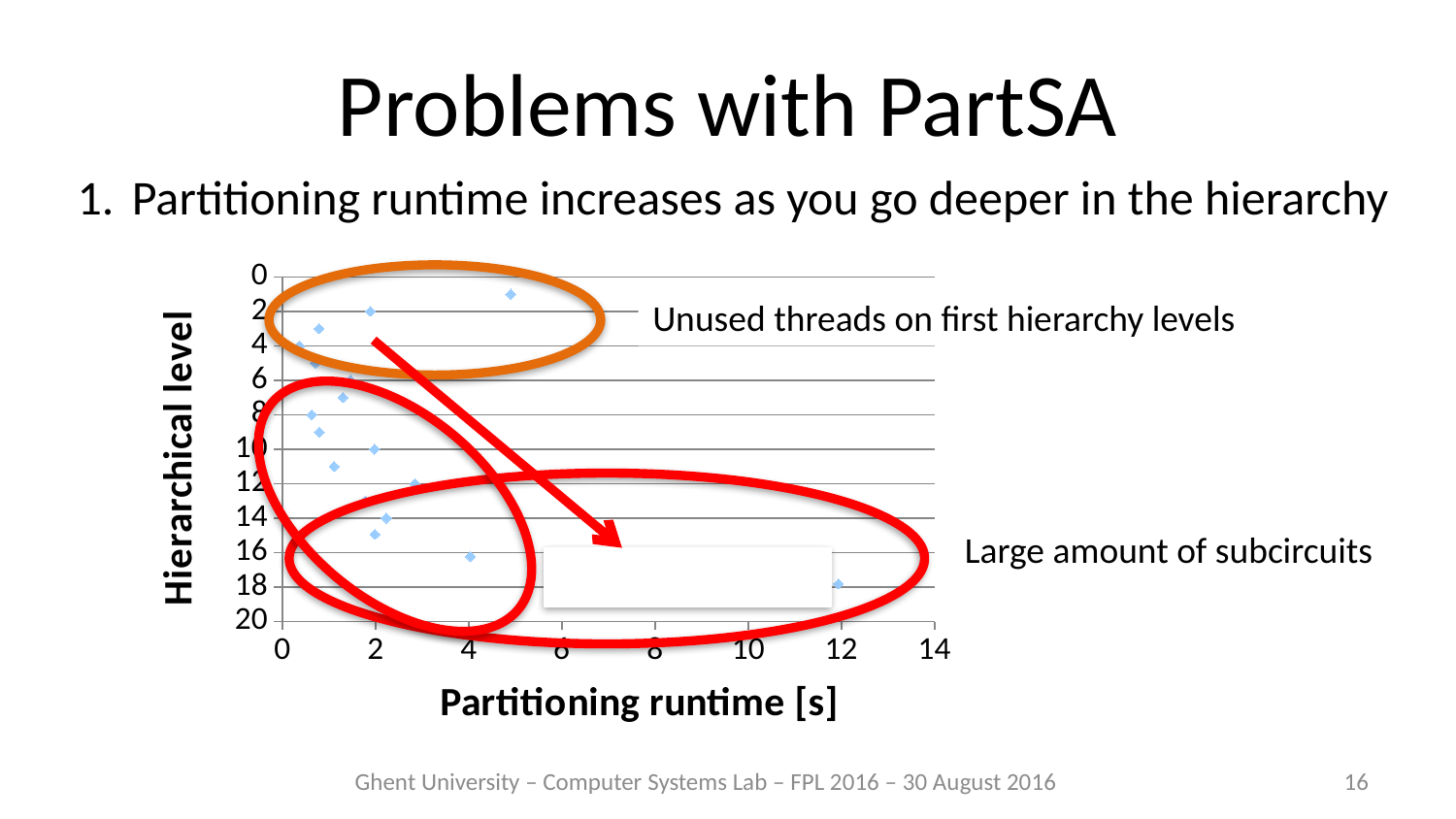
Which point has a larger partitioning runtime: the one at hierarchical level 18 or the one at hierarchical level 1? hierarchical level 18 What is the label of the y axis of the chart? Hierarchical level What is the label of the x axis of the chart? Partitioning runtime [s] What is the maximum value shown on the x axis of the chart? 14 What kind of chart is shown on the slide? scatter chart Is the partitioning runtime of the point at hierarchical level 1 greater or less than 6 seconds? less According to the chart, does partitioning runtime generally increase or decrease as the hierarchical level gets deeper? increase Is the partitioning runtime of the point at hierarchical level 18 greater or less than 10 seconds? greater Which hierarchical level has the point with the largest partitioning runtime? 18